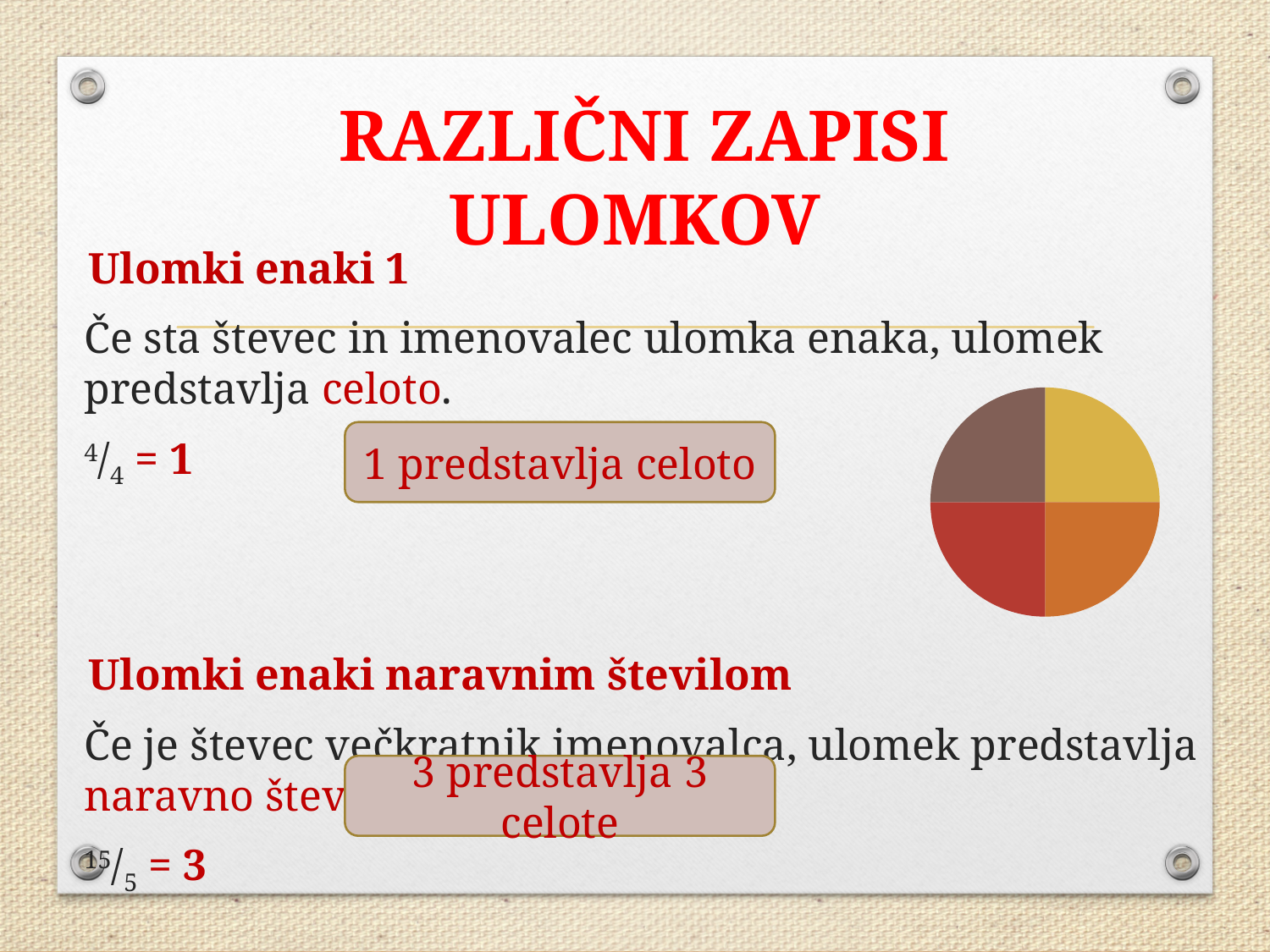
Does the pie chart have a legend? no What colour is the top-right slice of the pie chart? yellow What kind of chart is shown on the slide? pie chart How many slices does the pie chart have? 4 What fraction of the whole does each slice of the pie chart represent? 1/4